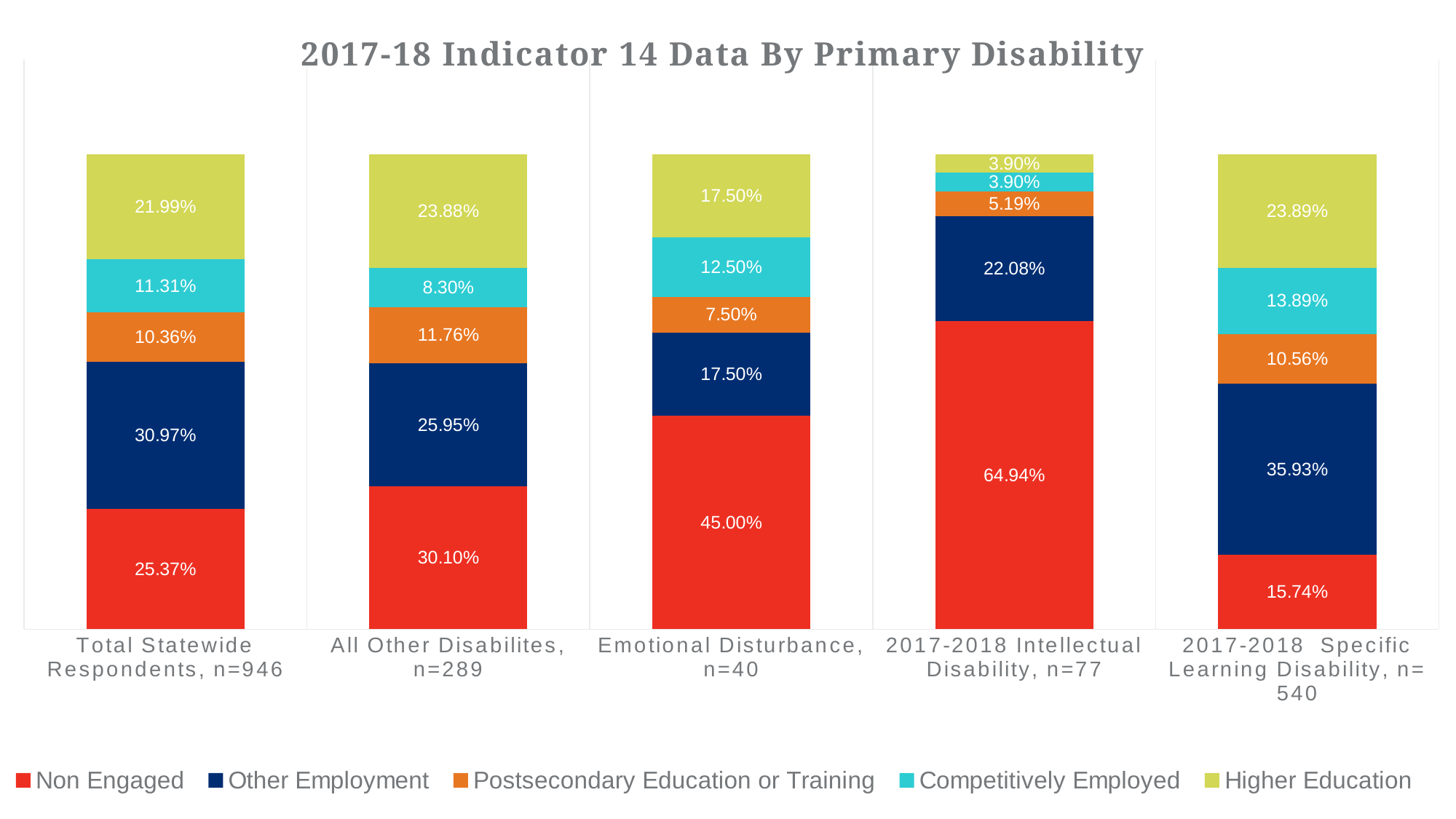
What is the difference between the Other Employment percentages for 2017-2018 Specific Learning Disability, n=540 and Total Statewide Respondents, n=946? 4.96% Which category has the highest Non Engaged percentage? 2017-2018 Intellectual Disability, n=77 Which has a larger Competitively Employed percentage: Emotional Disturbance, n=40 or Total Statewide Respondents, n=946? Emotional Disturbance, n=40 What is the title of the chart? 2017-18 Indicator 14 Data By Primary Disability How many categories are shown on the x axis? 5 What is the Higher Education percentage for 2017-2018 Specific Learning Disability, n=540? 23.89% How much higher is the Non Engaged percentage for 2017-2018 Intellectual Disability, n=77 than for Total Statewide Respondents, n=946? 39.57% What is the Other Employment percentage for 2017-2018 Intellectual Disability, n=77? 22.08% How many series does the legend list? 5 What kind of chart is shown on the slide? Stacked bar chart What is the Non Engaged percentage for Emotional Disturbance, n=40? 45.00% Which category has the lowest Non Engaged percentage? 2017-2018 Specific Learning Disability, n=540